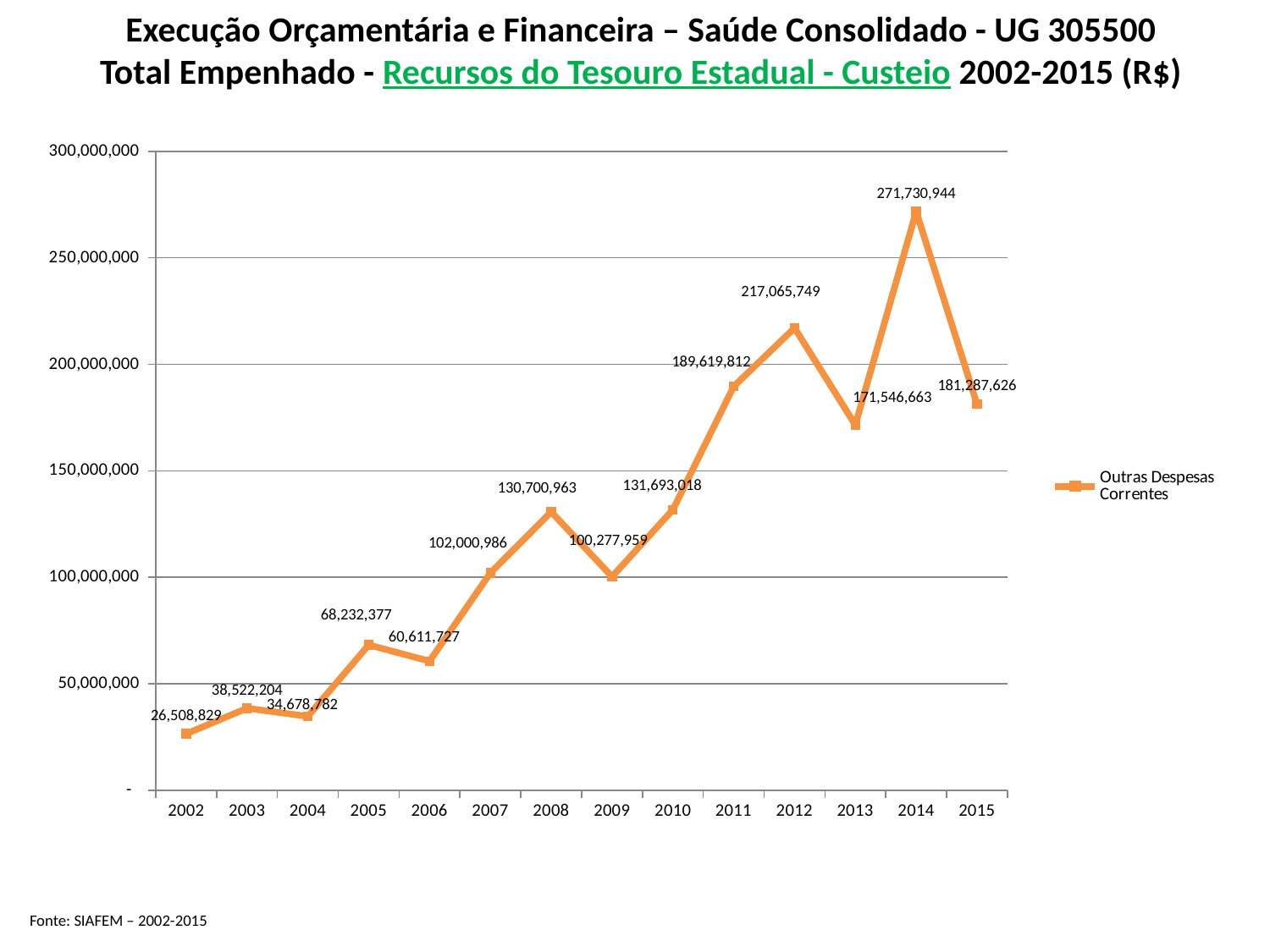
Which is larger, the value for 2008 or the value for 2010? 2010 What is the value for 2002? 26,508,829 What is the value for 2009? 100,277,959 Which year has the highest value? 2014 Is the value for 2012 greater or less than 200,000,000? greater What is the difference between the values for 2012 and 2011? 27,445,937 How many series does the legend list? 1 What is the value for 2014? 271,730,944 Which year has the lowest value? 2002 How many years are plotted on the chart? 14 What is the difference between the values for 2014 and 2013? 100,184,281 What kind of chart is shown? Line chart